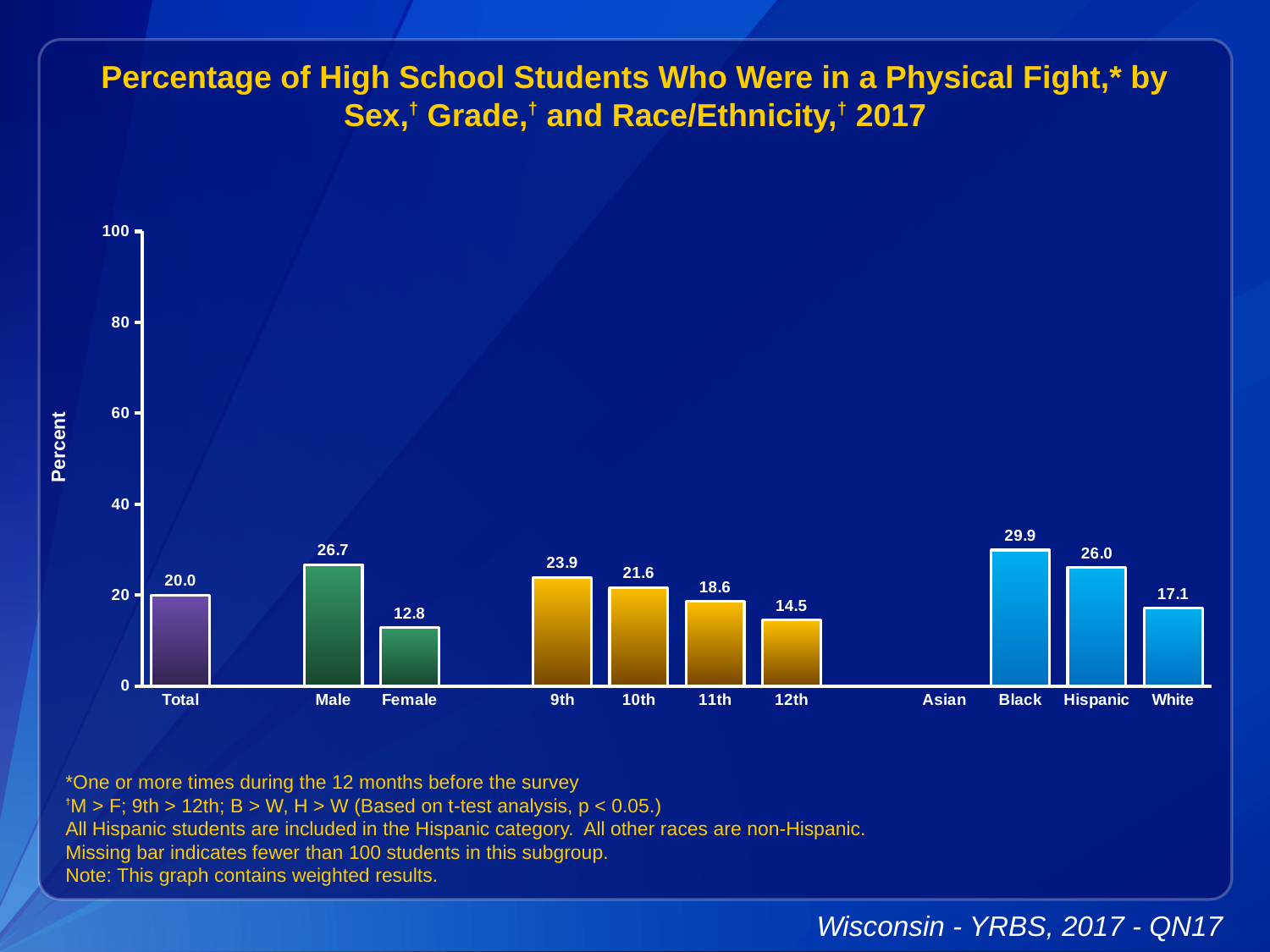
What is the value for Hispanic? 26.0 How many categories are labelled on the x axis? 11 Which category has the highest value? Black Do the values fall or rise from 9th grade to 12th grade? fall Which is larger, the value for 9th grade or the value for 11th grade? 9th Which category with a plotted bar has the lowest value? Female What is the value for 12th grade? 14.5 What is the difference between the Male and Female values? 13.9 Is the value for Total greater or less than 40? less What kind of chart is shown? bar chart Which category has no bar plotted? Asian What is the value for Male? 26.7